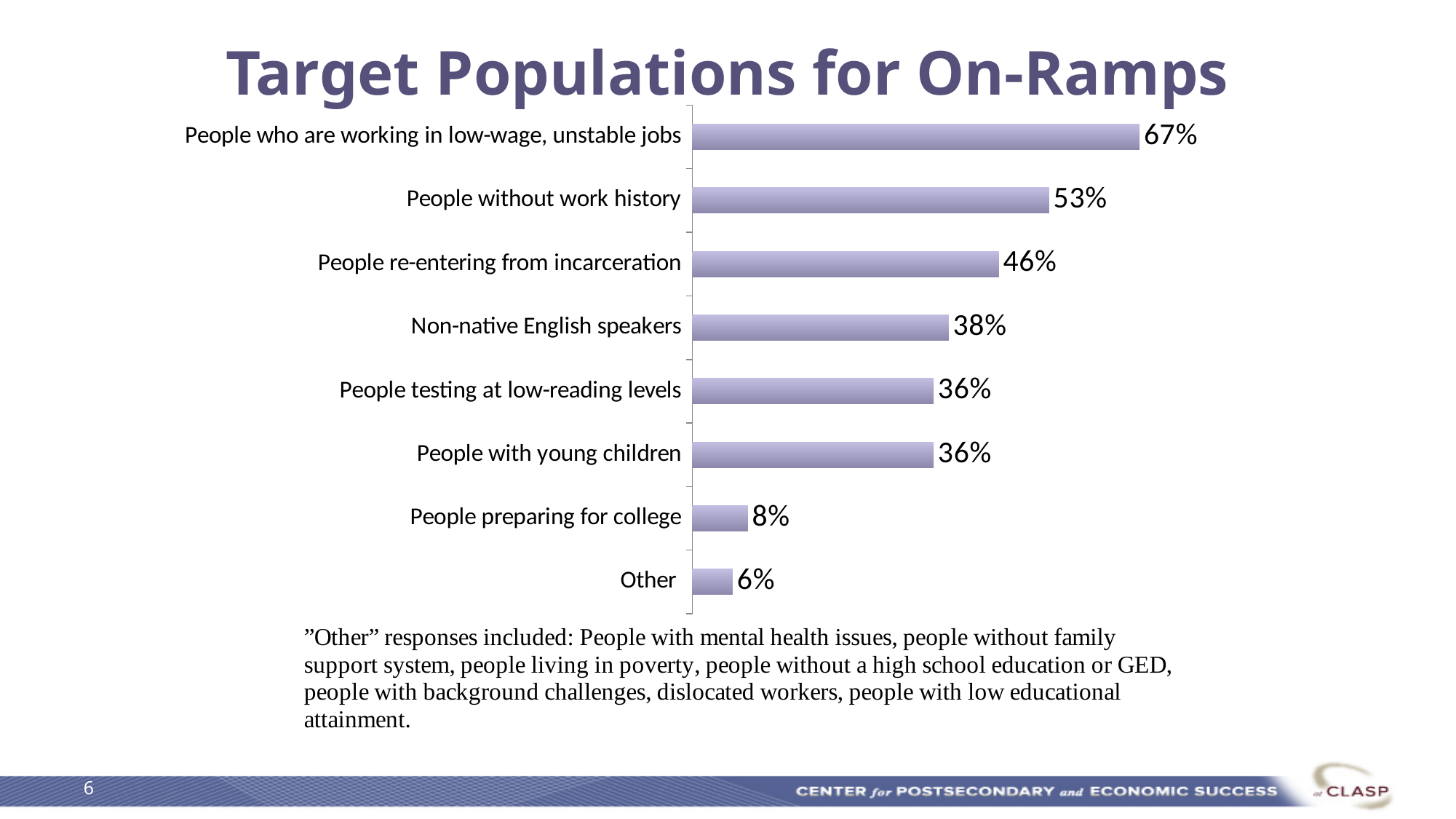
How many categories are shown in the chart? 8 What is the difference between the values for People without work history and People re-entering from incarceration? 7% What is the value for People re-entering from incarceration? 46% Which category has the highest value? People who are working in low-wage, unstable jobs What is the value for People preparing for college? 8% What kind of chart is shown on the slide? Bar chart What percentage is shown for Non-native English speakers? 38% Which category has the lowest value? Other What percentage is shown for People who are working in low-wage, unstable jobs? 67% What is the title of the slide? Target Populations for On-Ramps Which is larger: the value for People without work history or the value for Non-native English speakers? People without work history What is the difference between the values for People who are working in low-wage, unstable jobs and Other? 61%